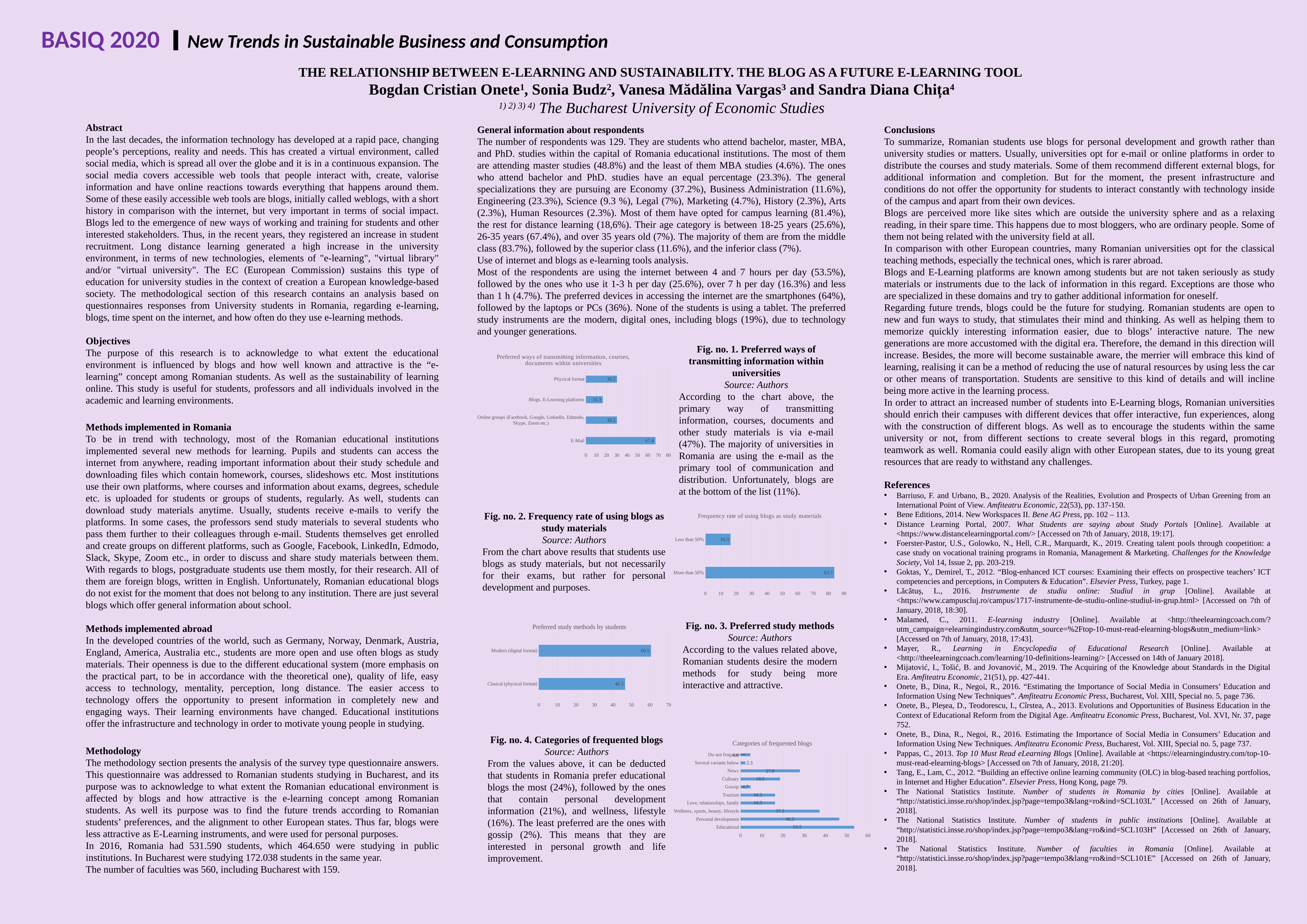
In the chart 'Preferred study methods by students', what is the value for Modern (digital format)? 60.5 In the chart 'Preferred ways of transmitting information, courses, documents within universities', what is the value for E-Mail? 67.4 In the chart 'Frequency rate of using blogs as study materials', how many categories are shown? 2 In the chart 'Preferred study methods by students', which is larger: Modern (digital format) or Clasical (physical format)? Modern (digital format) In the chart 'Frequency rate of using blogs as study materials', what is the value for More than 50%? 83.7 What type of chart is 'Frequency rate of using blogs as study materials'? Bar chart In the chart 'Categories of frequented blogs', what is the value for Personal development? 46.5 In the chart 'Preferred ways of transmitting information, courses, documents within universities', which category has the lowest value? Blogs, E-Learning platforms In the chart 'Categories of frequented blogs', which category has the highest value? Educational In the chart 'Preferred ways of transmitting information, courses, documents within universities', what is the difference between the values for E-Mail and Physical format? 37.2 In the chart 'Categories of frequented blogs', what is the value for Wellness, sports, beauty, lifestyle? 37.2 In the chart 'Categories of frequented blogs', is the value for News greater or less than 20? greater